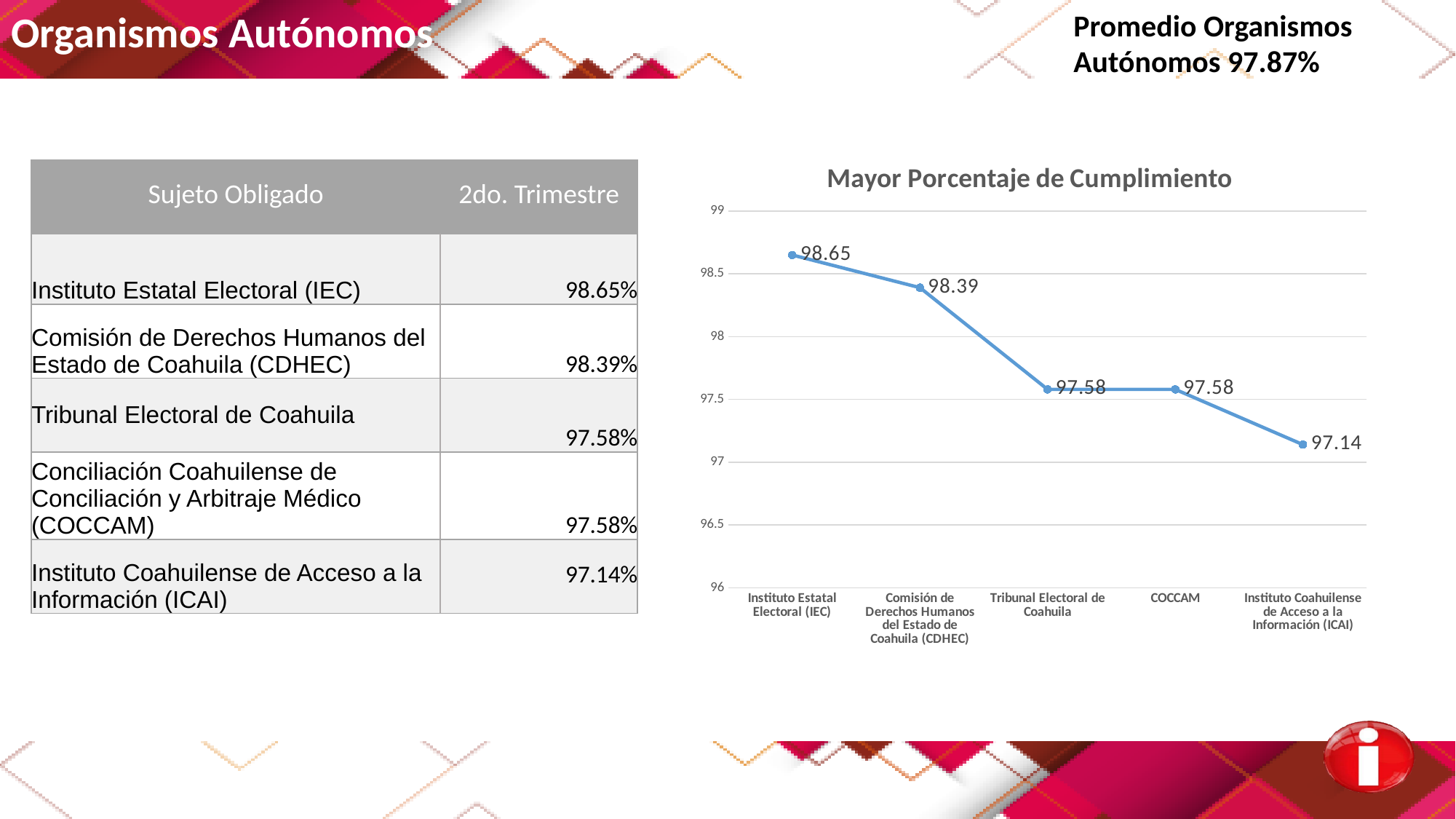
What is the value plotted for Instituto Coahuilense de Acceso a la Información (ICAI)? 97.14 How many categories are plotted on the x axis of the chart? 5 What is the difference between the values for Instituto Estatal Electoral (IEC) and Instituto Coahuilense de Acceso a la Información (ICAI)? 1.51 Which category has the highest value in the chart? Instituto Estatal Electoral (IEC) What is the value plotted for Instituto Estatal Electoral (IEC)? 98.65 Do the values rise or fall from left to right along the x axis? Fall Which is larger, the value for Comisión de Derechos Humanos del Estado de Coahuila (CDHEC) or the value for Tribunal Electoral de Coahuila? Comisión de Derechos Humanos del Estado de Coahuila (CDHEC) What is the value plotted for Comisión de Derechos Humanos del Estado de Coahuila (CDHEC)? 98.39 Which category has the lowest value in the chart? Instituto Coahuilense de Acceso a la Información (ICAI) What type of chart is shown on the slide? Line chart What is the title of the chart? Mayor Porcentaje de Cumplimiento What is the value plotted for COCCAM? 97.58